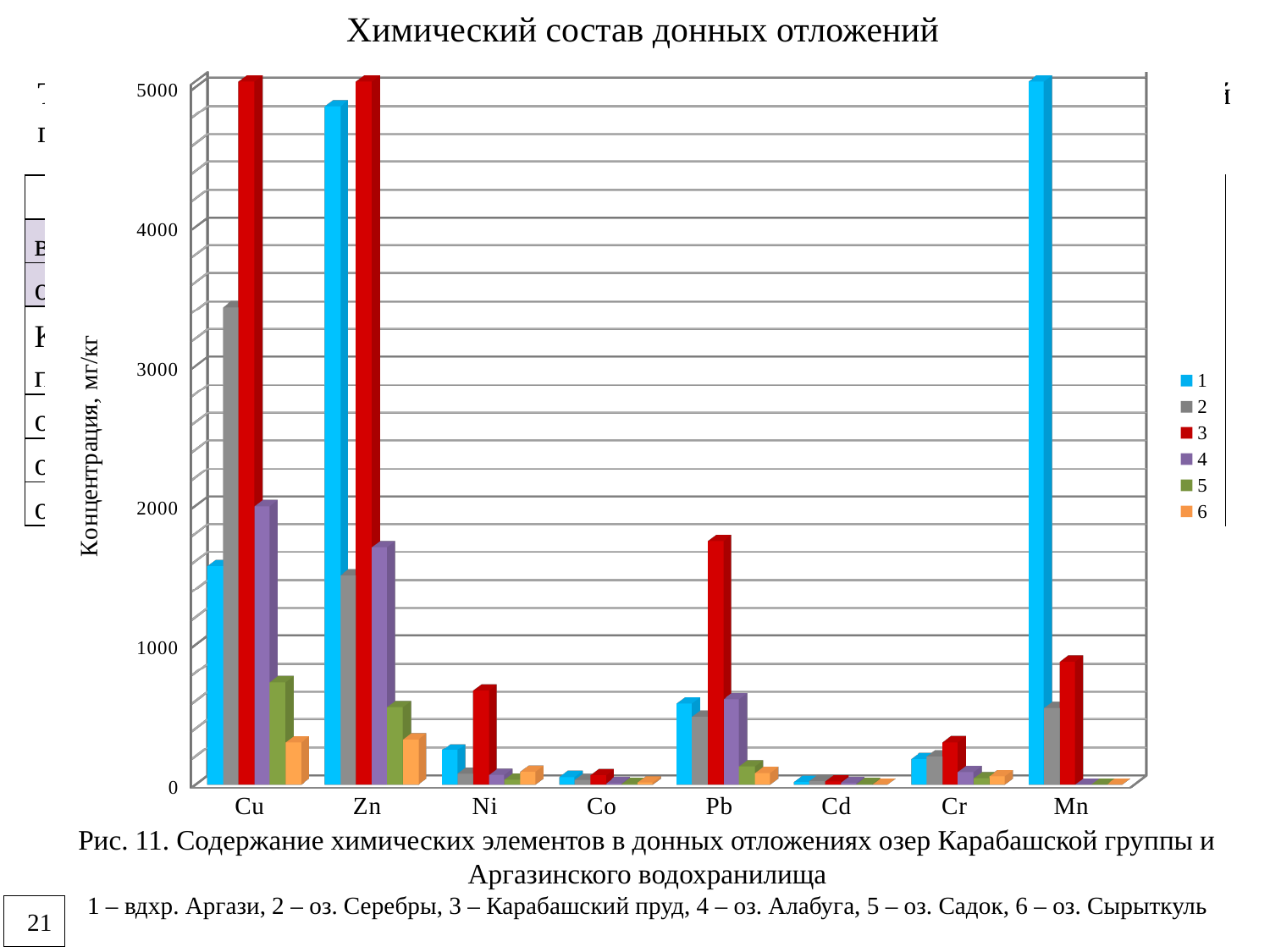
How many chemical elements (categories) are shown on the x axis? 8 How many series does the legend list? 6 Is the value of series 3 for Mn greater or less than 1000? less For Cu, which is larger: the value of series 2 or series 4? series 2 For Pb, which is larger: the value of series 1 or series 3? series 3 Which series has the lowest value for Cu? 6 Is the value of series 2 for Cu greater or less than 3000? greater Is the value of series 3 for Pb greater or less than 1000? greater What is the label of the vertical axis? Концентрация, мг/кг What kind of chart is shown on the slide? bar chart Which series has the highest value for Mn? 1